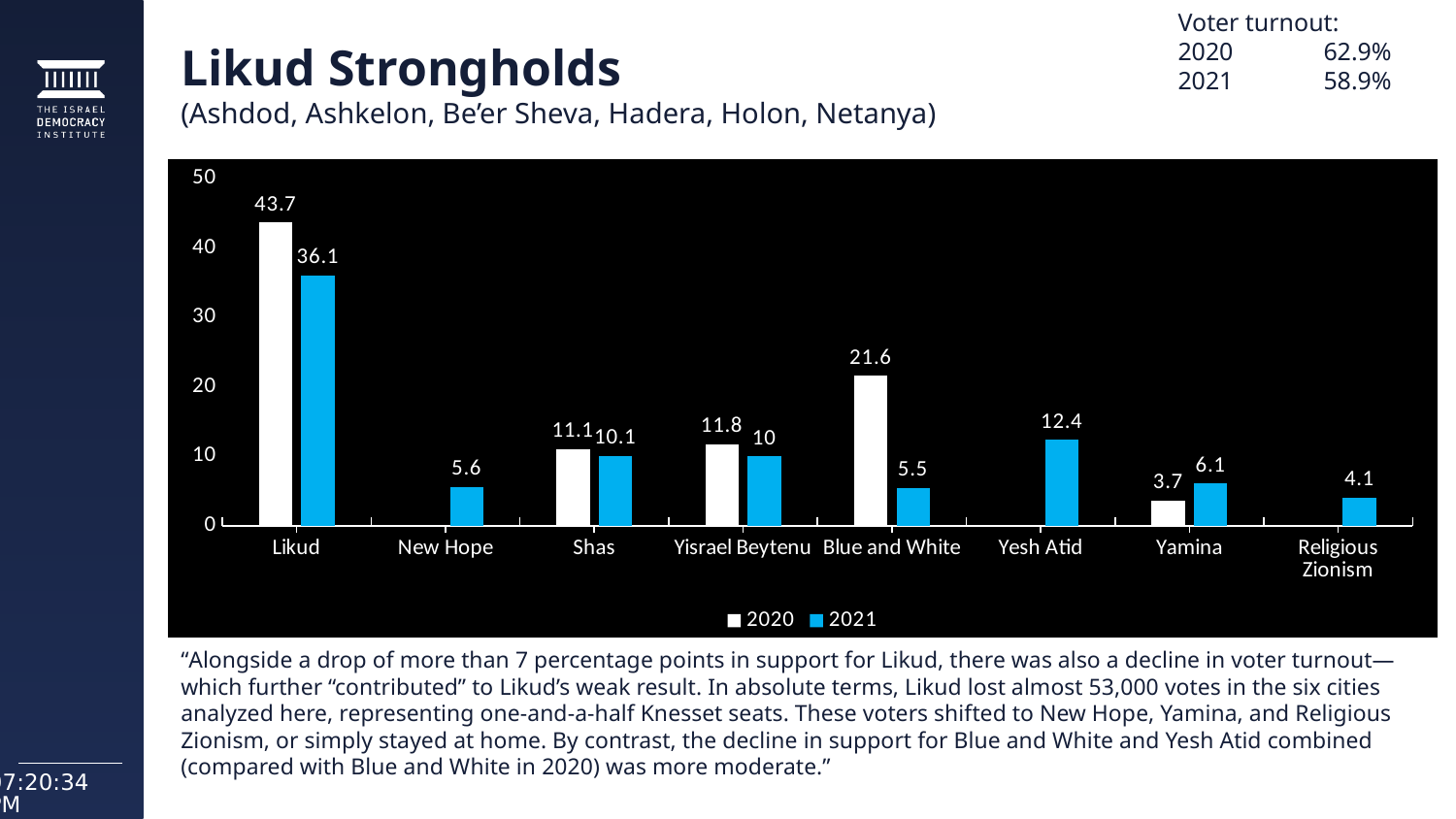
What is the 2020 value for Blue and White? 21.6 What is the difference between Likud's 2020 and 2021 values? 7.6 Which party has the lowest 2021 value? Religious Zionism How many parties are shown on the x axis? 8 What is the 2021 value for Likud? 36.1 What kind of chart is shown? Bar chart How many series does the legend list? 2 What is the 2021 value for Yesh Atid? 12.4 Which party has the highest 2021 value? Likud What is the difference between Blue and White's 2020 and 2021 values? 16.1 What is the 2020 value for Likud? 43.7 Which is larger for Yamina: the 2020 value or the 2021 value? 2021